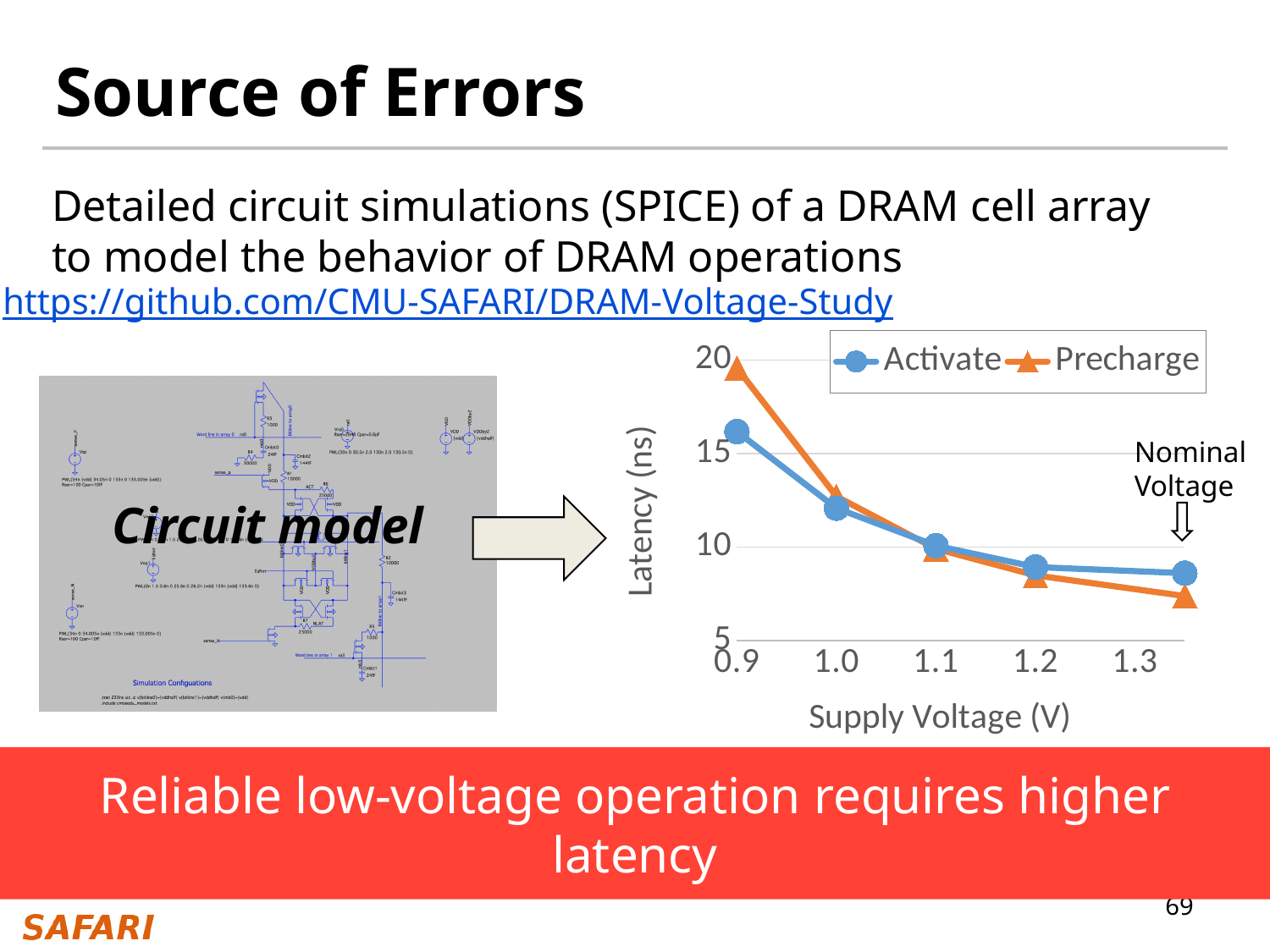
What is the label of the chart's y axis? Latency (ns) At which supply voltage is the Precharge latency highest? 0.9 Is the Precharge latency at 0.9 V greater or less than 15 ns? greater At a supply voltage of 0.9 V, which series has the higher latency, Activate or Precharge? Precharge How many series does the chart legend list? 2 What are the two series named in the chart legend? Activate and Precharge How many data points are plotted for the Activate series? 5 Is the Precharge latency at 1.2 V greater or less than 10 ns? less Is the Activate latency at 0.9 V greater or less than 15 ns? greater What kind of chart is shown on the slide? line chart As supply voltage increases along the x axis, does latency rise or fall? fall